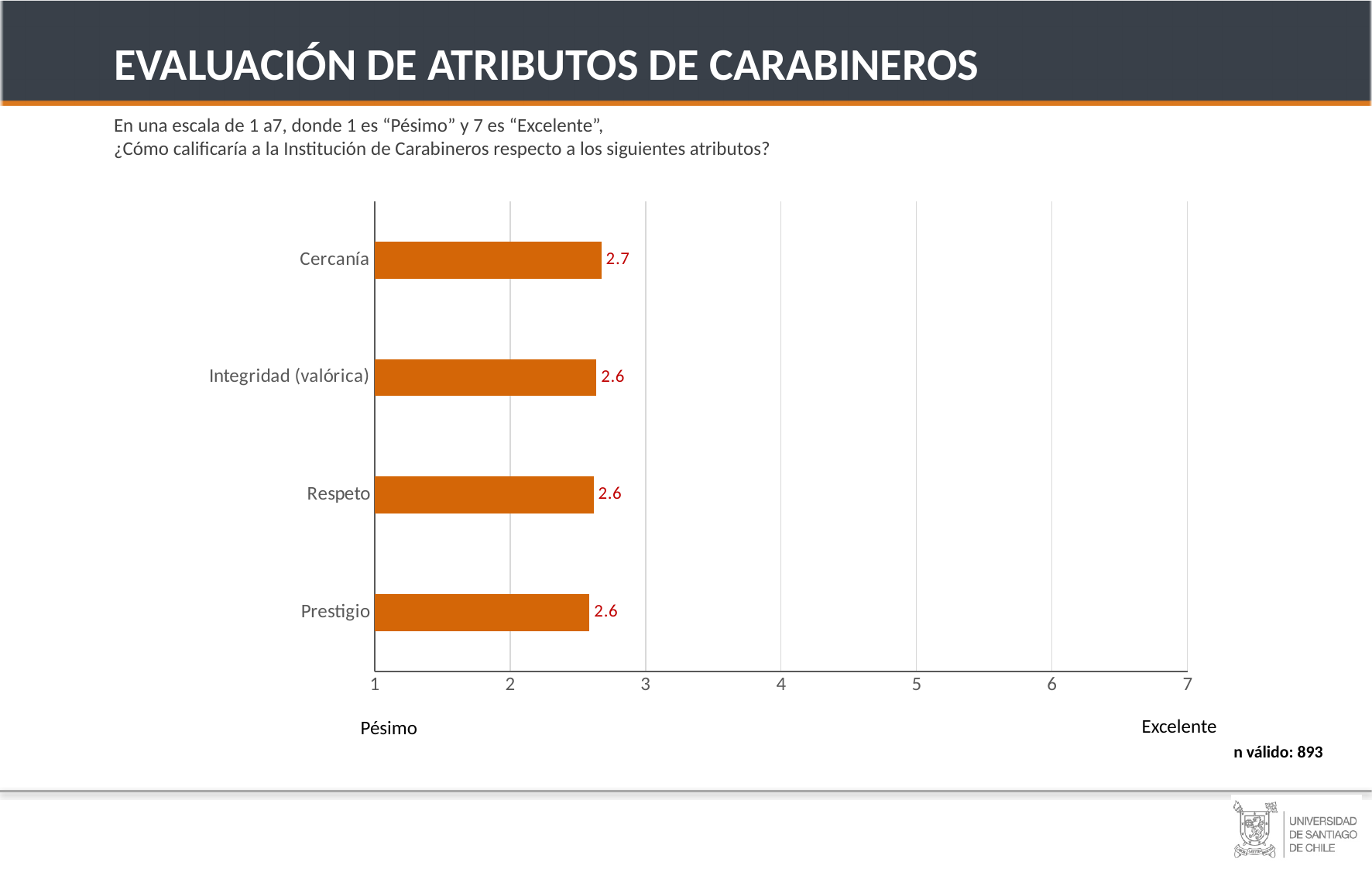
Which attribute has the highest value? Cercanía What is the difference between the values for Cercanía and Prestigio? 0.1 What kind of chart is shown on the slide? bar chart What is the value for Integridad (valórica)? 2.6 What is the value for Cercanía? 2.7 How many attributes are shown in the chart? 4 What is the value for Prestigio? 2.6 What is the value for Respeto? 2.6 What is the valid n reported on the slide? 893 Is the value for Prestigio greater or less than 2? greater What is the maximum value shown on the horizontal axis? 7 Is the value for Cercanía greater or less than 3? less